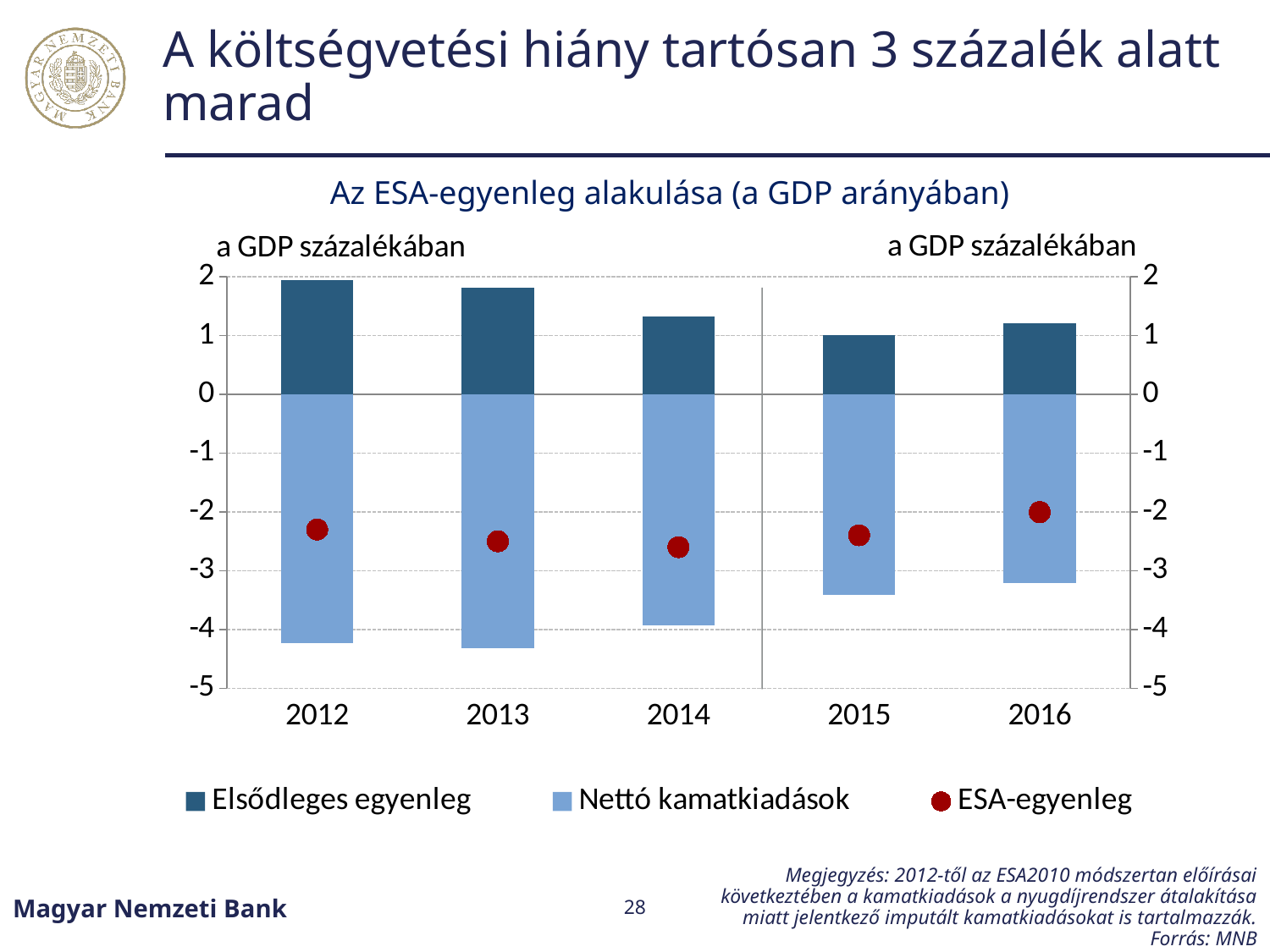
How many years are shown on the x axis of the chart? 5 What is the title of the chart? Az ESA-egyenleg alakulása (a GDP arányában) In which year is the Elsődleges egyenleg bar the lowest? 2015 In which year is the ESA-egyenleg marker highest? 2016 Is the Nettó kamatkiadások value for 2015 greater or less than -4? greater How many series does the chart's legend list? 3 Is the ESA-egyenleg value for 2012 greater or less than -2? less What kind of chart is shown on the slide? bar chart Is the Nettó kamatkiadások value for 2012 greater or less than -4? less Which is larger, the ESA-egyenleg value for 2016 or for 2012? 2016 Which series is shown with red circular markers in the chart? ESA-egyenleg